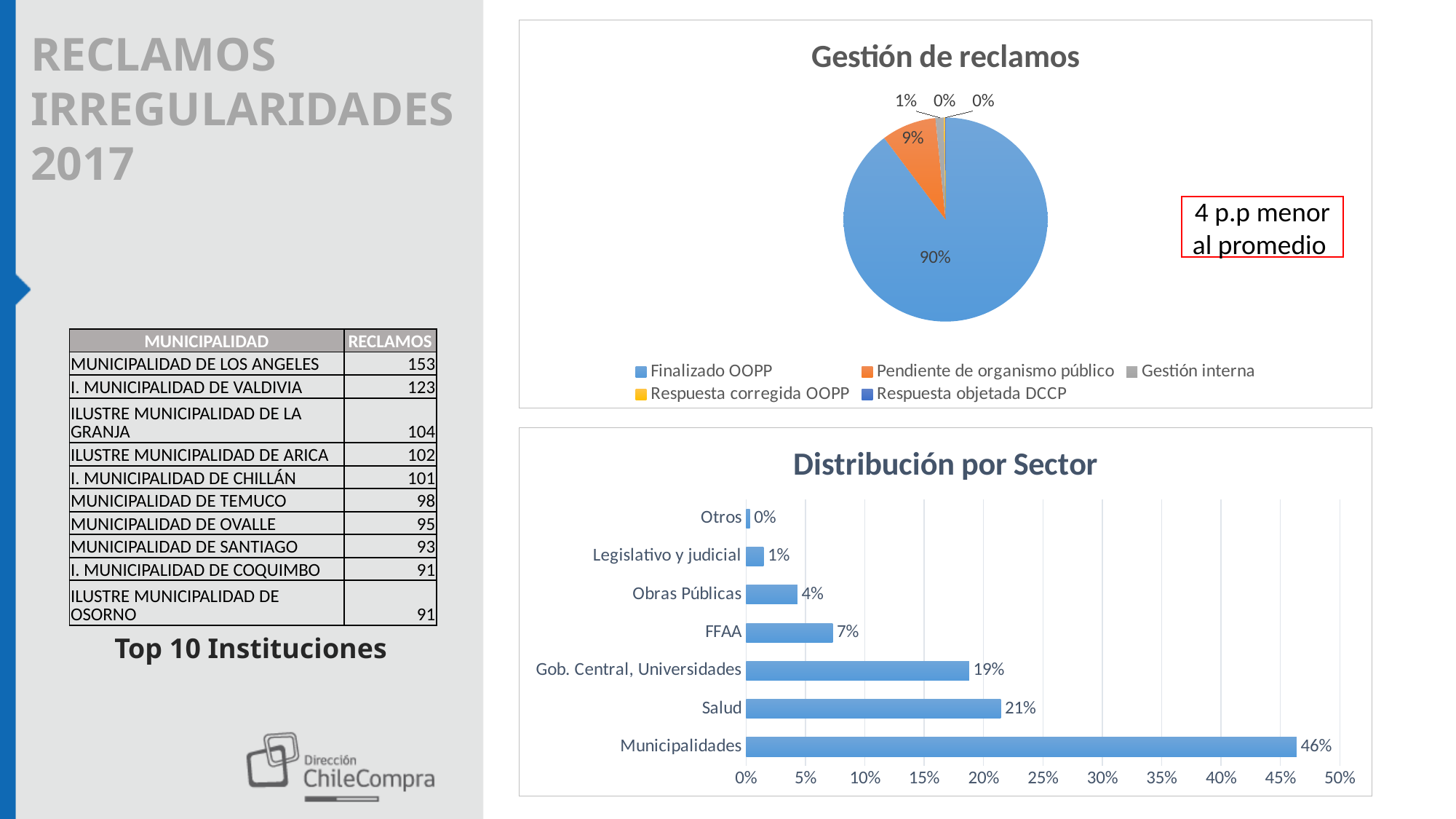
How many entries does the legend of the 'Gestión de reclamos' chart list? 5 In the 'Distribución por Sector' chart, what is the value for Salud? 21% In the 'Gestión de reclamos' chart, what share of the pie is Finalizado OOPP? 90% In the 'Distribución por Sector' chart, which is larger, FFAA or Obras Públicas? FFAA In the 'Gestión de reclamos' chart, which category has the largest slice? Finalizado OOPP In the 'Distribución por Sector' chart, what is the difference between Municipalidades and Salud? 25% What kind of chart is 'Gestión de reclamos'? Pie chart In the 'Distribución por Sector' chart, what is the value for Municipalidades? 46% How many sectors are shown in the 'Distribución por Sector' chart? 7 In the 'Distribución por Sector' chart, which sector has the lowest value? Otros What kind of chart is 'Distribución por Sector'? Bar chart In the 'Gestión de reclamos' chart, what percentage is shown for Pendiente de organismo público? 9%